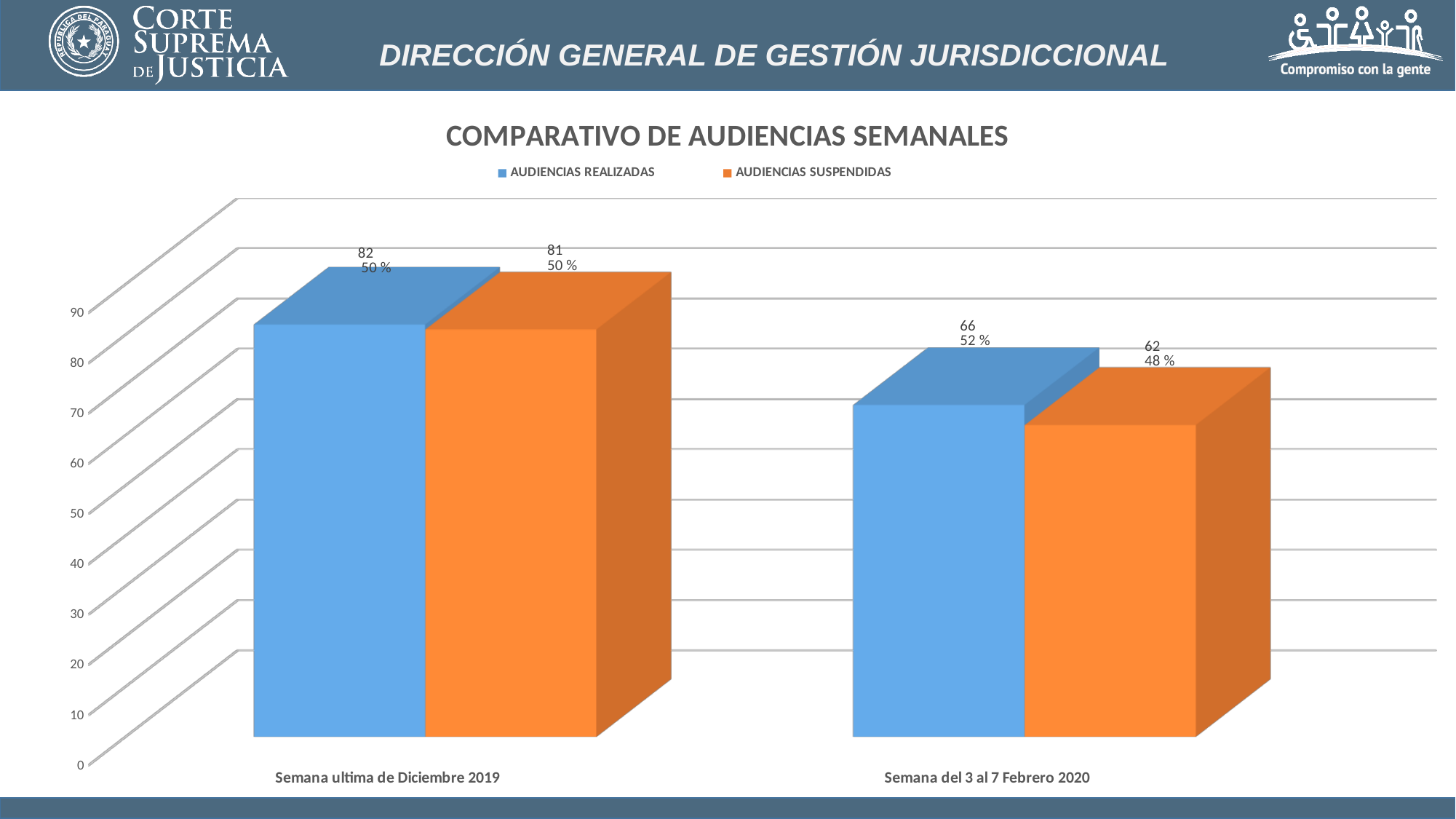
Which category has the highest value for AUDIENCIAS REALIZADAS? Semana ultima de Diciembre 2019 What is the value of AUDIENCIAS REALIZADAS for Semana ultima de Diciembre 2019? 82 What is the title of the chart? COMPARATIVO DE AUDIENCIAS SEMANALES What is the difference between AUDIENCIAS REALIZADAS in Semana ultima de Diciembre 2019 and Semana del 3 al 7 Febrero 2020? 16 Which is larger in Semana del 3 al 7 Febrero 2020: AUDIENCIAS REALIZADAS or AUDIENCIAS SUSPENDIDAS? AUDIENCIAS REALIZADAS What percentage is shown for AUDIENCIAS REALIZADAS in Semana del 3 al 7 Febrero 2020? 52 % Which category has the lowest value for AUDIENCIAS SUSPENDIDAS? Semana del 3 al 7 Febrero 2020 How many series does the legend list? 2 What kind of chart is shown on the slide? Bar chart What is the value of AUDIENCIAS SUSPENDIDAS for Semana del 3 al 7 Febrero 2020? 62 What is the value of AUDIENCIAS SUSPENDIDAS for Semana ultima de Diciembre 2019? 81 How many categories are shown on the x axis? 2